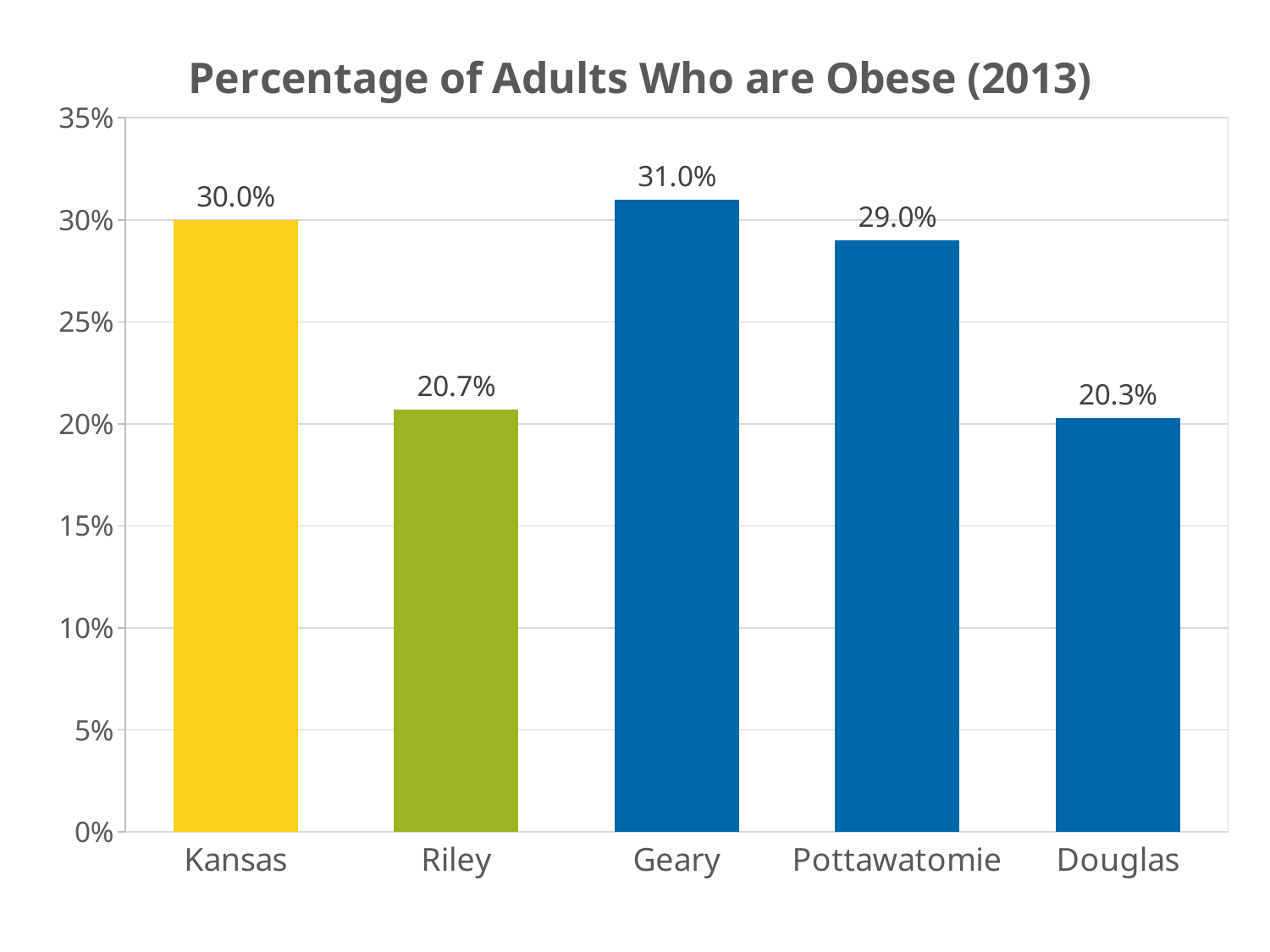
What is the difference between the obesity percentages for Kansas and Riley? 9.3% What is the difference between the obesity percentages for Geary and Douglas? 10.7% Which has a higher percentage of obese adults, Geary or Pottawatomie? Geary What is the title of the chart? Percentage of Adults Who are Obese (2013) How many categories are shown on the chart? 5 Which category has the lowest percentage of obese adults? Douglas Which category has the highest percentage of obese adults? Geary What kind of chart is shown on the slide? Bar chart What is the percentage of adults who are obese in Riley? 20.7% Is the value for Riley greater or less than 25%? less What is the percentage of adults who are obese in Kansas? 30.0% What is the percentage of adults who are obese in Pottawatomie? 29.0%